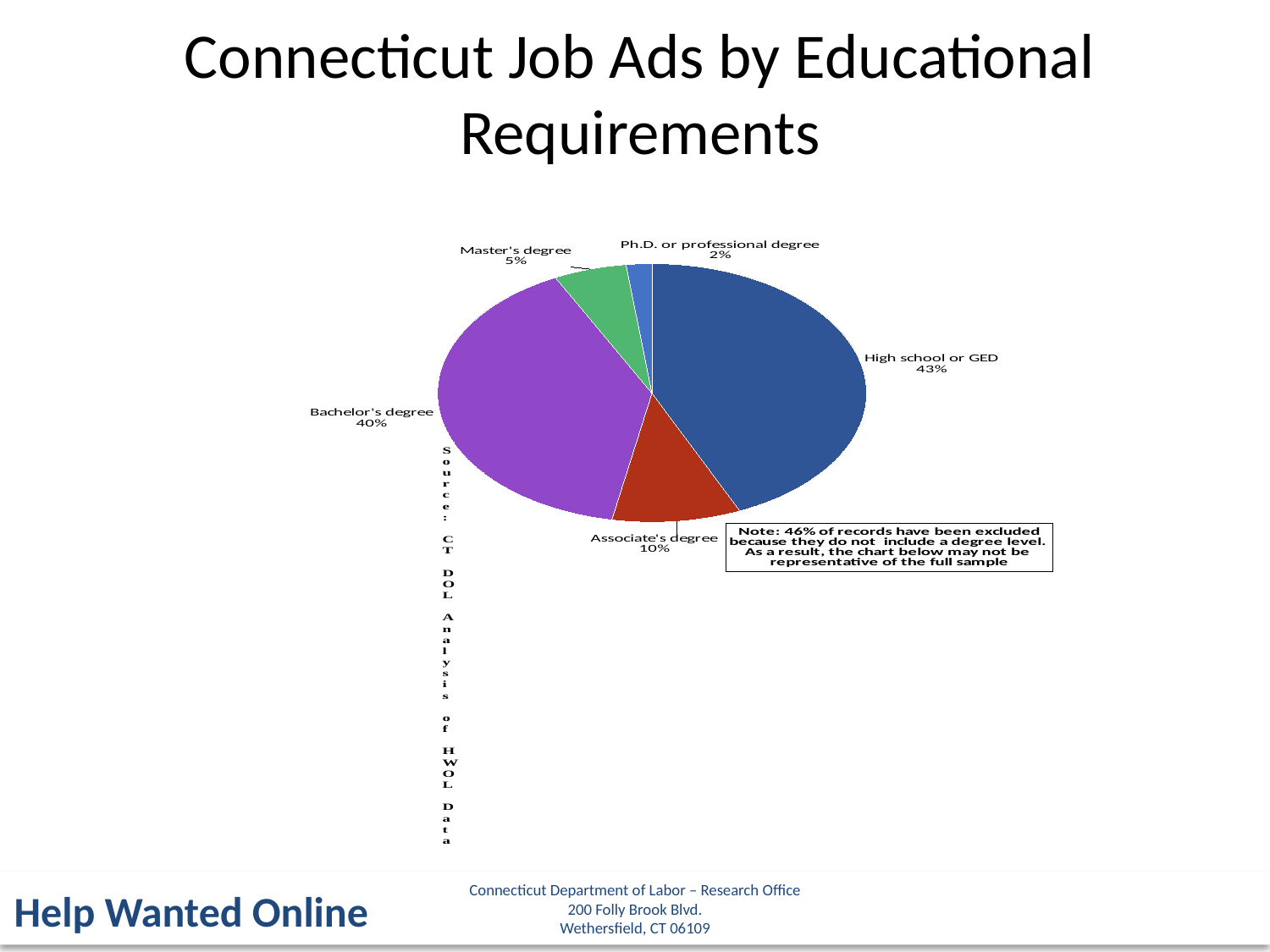
What share of job ads require an Associate's degree? 10% What share of job ads require a Ph.D. or professional degree? 2% Which educational requirement has the smallest share of job ads? Ph.D. or professional degree What share of job ads require a Bachelor's degree? 40% How many educational requirement categories are shown in the pie chart? 5 According to the note on the chart, what percentage of records have been excluded because they do not include a degree level? 46% What share of Connecticut job ads require a High school or GED? 43% Which educational requirement has the largest share of job ads? High school or GED Which is larger: the share for Associate's degree or the share for Master's degree? Associate's degree What kind of chart is shown on the slide? Pie chart What share of job ads require a Master's degree? 5% How many percentage points larger is the High school or GED share than the Bachelor's degree share? 3